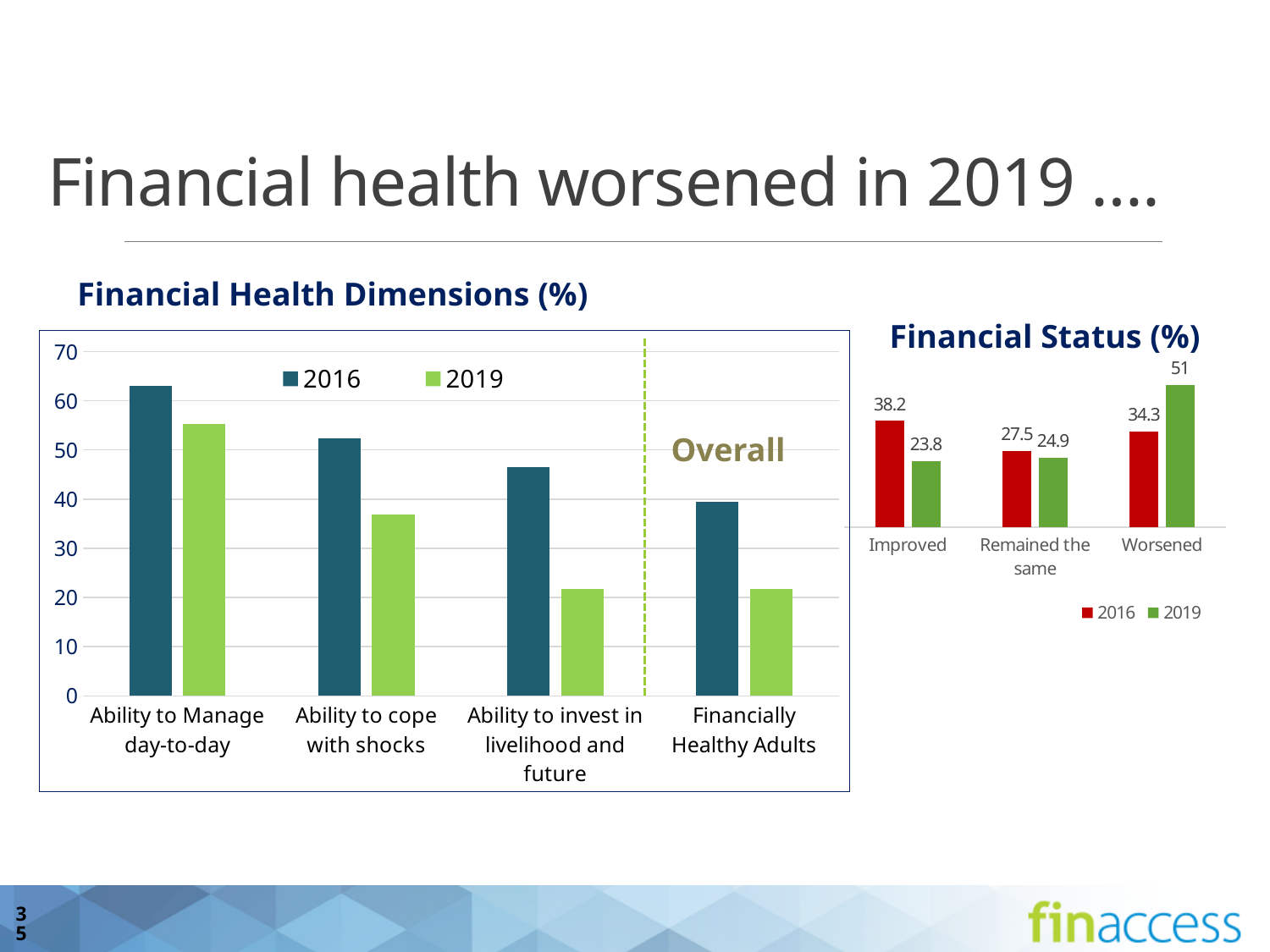
In the Financial Health Dimensions (%) chart, is the 2016 value for Ability to invest in livelihood and future greater or less than 50? less What kind of chart is the Financial Status (%) chart? bar chart In the Financial Status (%) chart, what is the 2019 value for Worsened? 51 In the Financial Status (%) chart, which category has the highest 2019 value? Worsened In the Financial Health Dimensions (%) chart, is the 2019 value for Financially Healthy Adults greater or less than 30? less In the Financial Status (%) chart, what is the 2016 value for Improved? 38.2 In the Financial Status (%) chart, what is the 2019 value for Remained the same? 24.9 In the Financial Status (%) chart, which category has the lowest 2016 value? Remained the same In the Financial Status (%) chart, is the 2016 value for Improved larger or smaller than the 2019 value for Improved? larger In the Financial Health Dimensions (%) chart, is the 2016 value for Ability to Manage day-to-day greater or less than 60? greater How many categories are shown on the x axis of the Financial Health Dimensions (%) chart? 4 In the Financial Status (%) chart, what is the difference between the 2019 and 2016 values for Worsened? 16.7